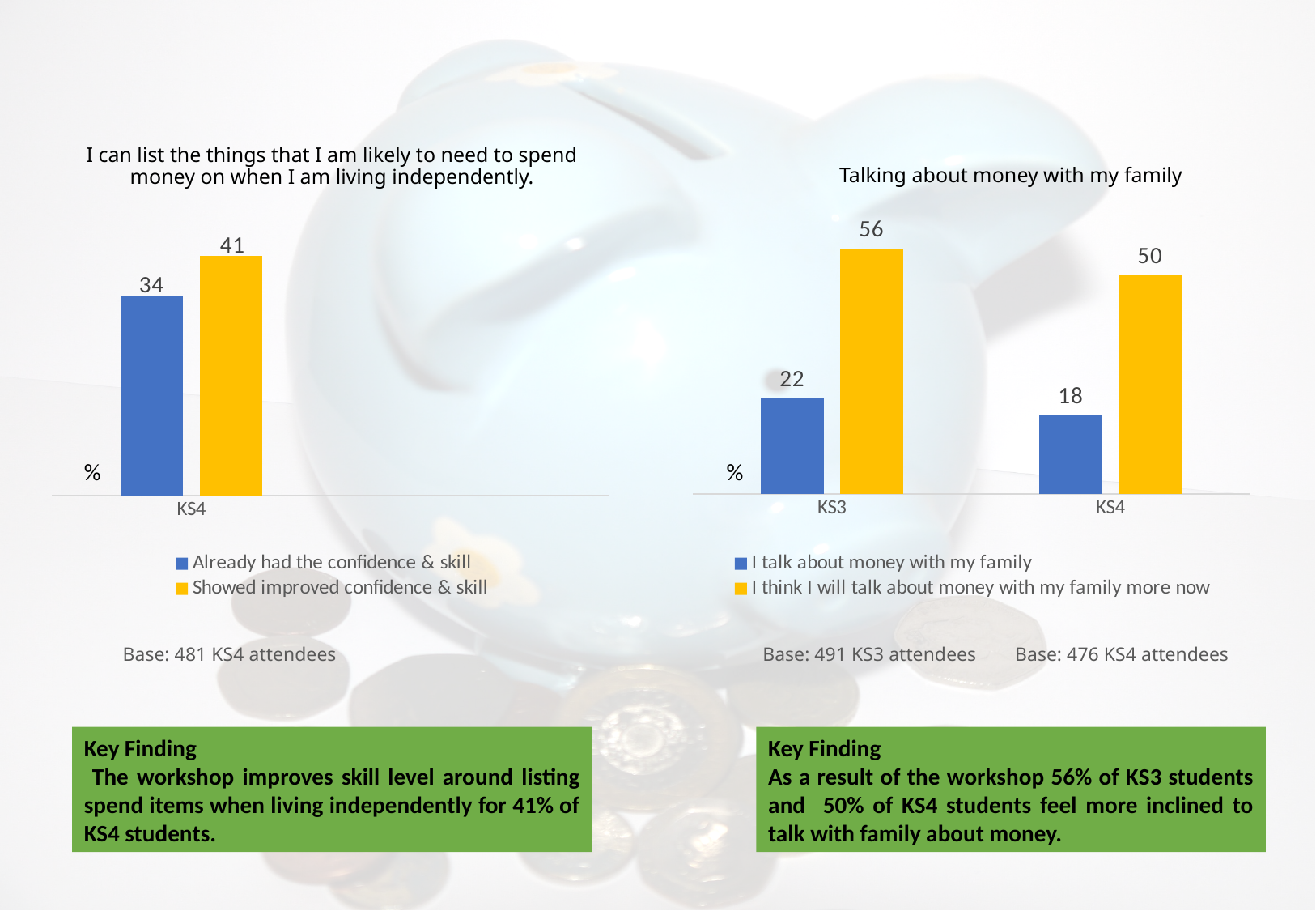
In the right chart ('Talking about money with my family'), what is the difference between 'I think I will talk about money with my family more now' and 'I talk about money with my family' for KS3? 34 In the right chart ('Talking about money with my family'), which category has the lowest value for 'I talk about money with my family'? KS4 In the right chart ('Talking about money with my family'), what is the value for 'I think I will talk about money with my family more now' for KS4? 50 In the left chart ('I can list the things that I am likely to need to spend money on when I am living independently.'), what is the difference between 'Showed improved confidence & skill' and 'Already had the confidence & skill' for KS4? 7 In the right chart ('Talking about money with my family'), is the value for 'I talk about money with my family' larger for KS3 or KS4? KS3 In the left chart ('I can list the things that I am likely to need to spend money on when I am living independently.'), how many series does the legend list? 2 What kind of chart is the right chart ('Talking about money with my family')? Bar chart In the left chart ('I can list the things that I am likely to need to spend money on when I am living independently.'), what is the value for 'Already had the confidence & skill' for KS4? 34 In the right chart ('Talking about money with my family'), which category has the highest value for 'I think I will talk about money with my family more now'? KS3 In the left chart ('I can list the things that I am likely to need to spend money on when I am living independently.'), what is the value for 'Showed improved confidence & skill' for KS4? 41 In the right chart ('Talking about money with my family'), what is the value for 'I talk about money with my family' for KS3? 22 In the right chart ('Talking about money with my family'), how many categories are shown on the x axis? 2